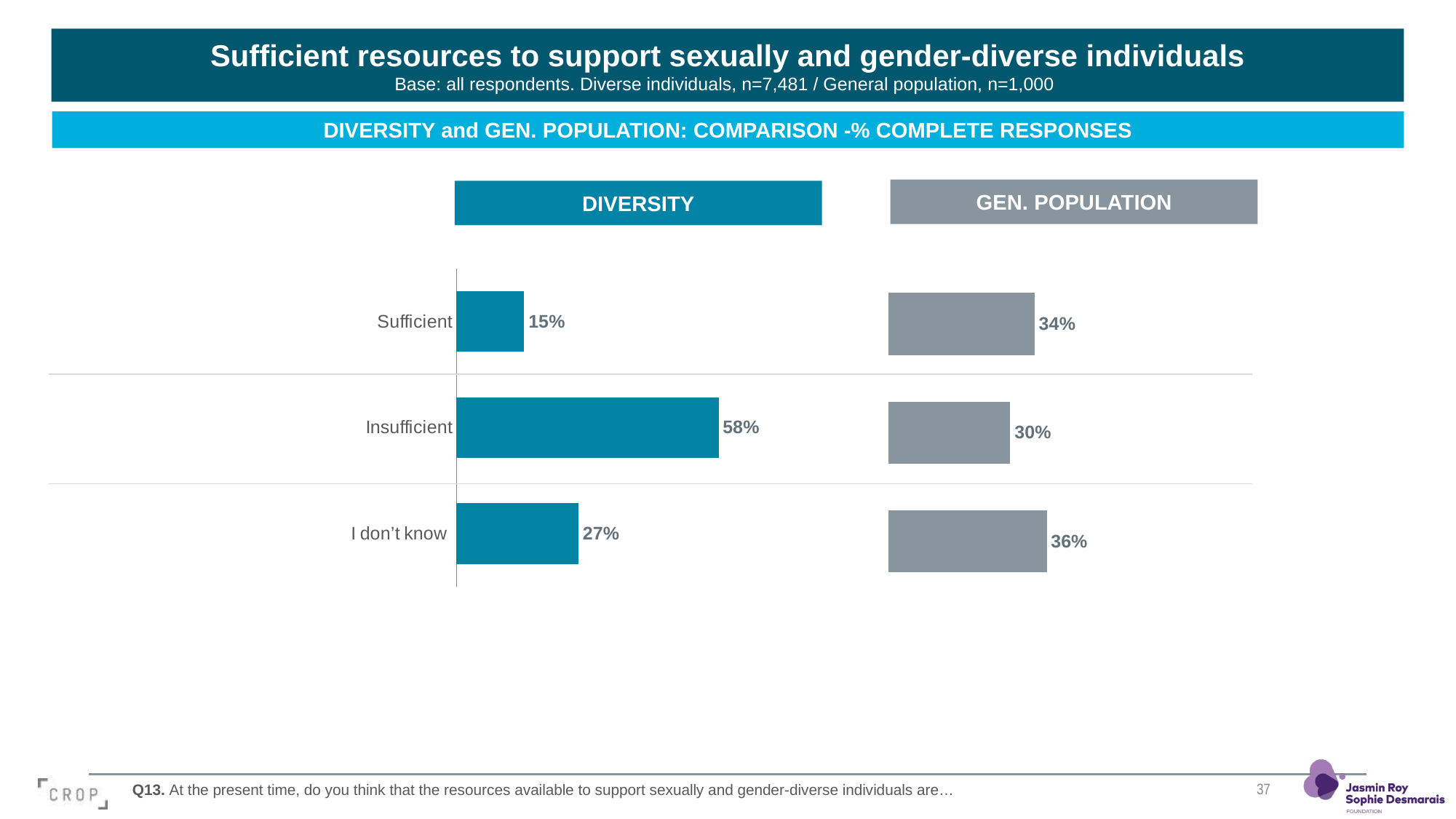
For Sufficient, which is larger: the DIVERSITY value or the GEN. POPULATION value? GEN. POPULATION What kind of chart is used on this slide? Bar chart In the DIVERSITY chart, what is the value for I don't know? 27% What is the difference between the GEN. POPULATION values for I don't know and Sufficient? 2 percentage points In the DIVERSITY chart, which category has the highest value? Insufficient In the DIVERSITY chart, what is the value for Insufficient? 58% What is the difference between the DIVERSITY and GEN. POPULATION values for Insufficient? 28 percentage points In the GEN. POPULATION chart, which category has the lowest value? Insufficient How many categories are shown in the DIVERSITY chart? 3 In the GEN. POPULATION chart, what is the value for Sufficient? 34% In the GEN. POPULATION chart, what is the value for Insufficient? 30% In the DIVERSITY chart, which category has the lowest value? Sufficient